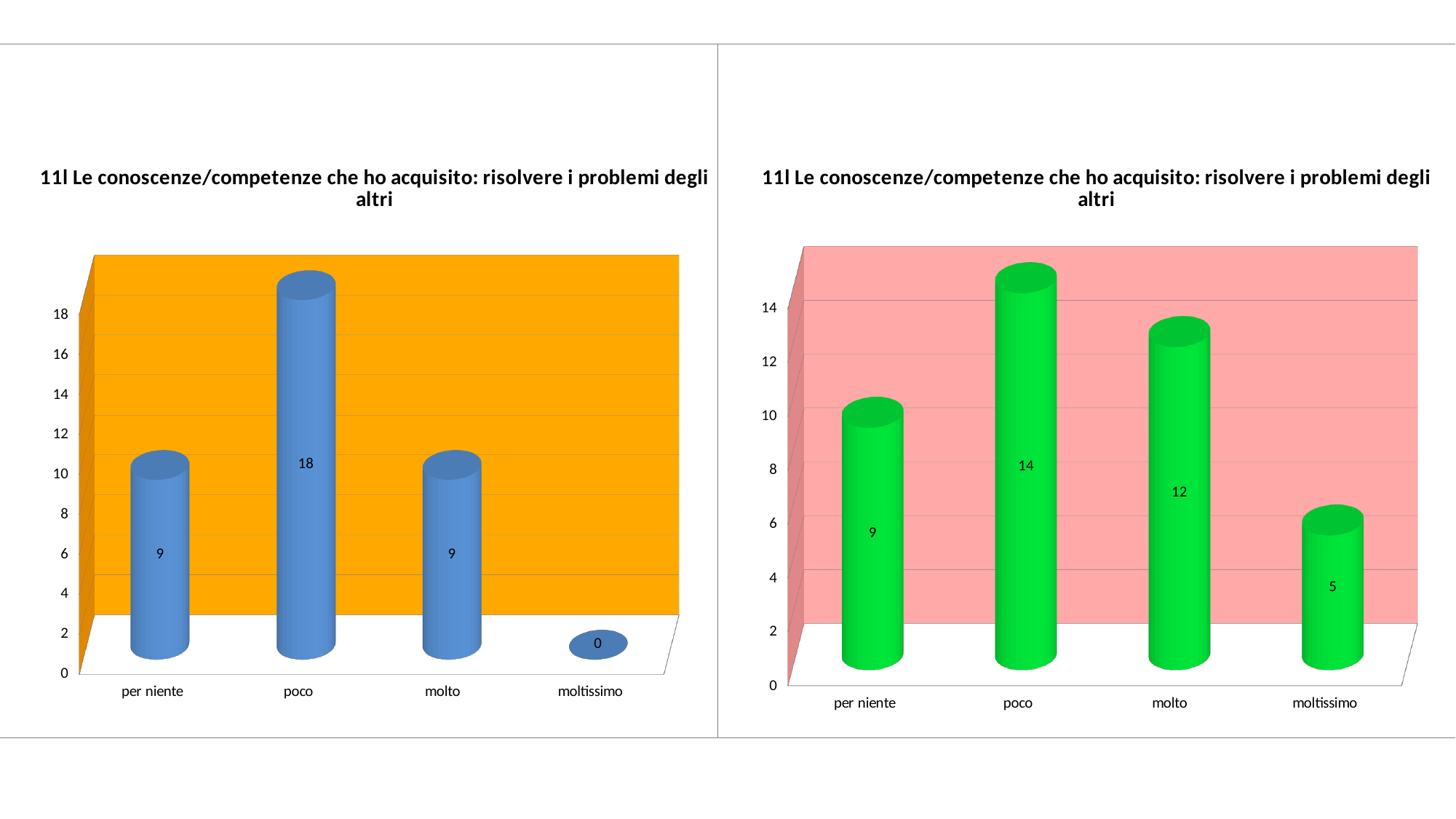
In the left chart, which category has the highest value? poco In the right chart, what is the value for "moltissimo"? 5 In the right chart, what is the difference between the values for "poco" and "molto"? 2 How many categories are shown on the x axis of the left chart? 4 What kind of chart is the right chart? bar chart In the right chart, which category has the lowest value? moltissimo In the left chart, what is the difference between the values for "poco" and "per niente"? 9 In the left chart, what is the value for "poco"? 18 In the right chart, which is larger, the value for "per niente" or the value for "molto"? molto In the right chart, what is the value for "molto"? 12 What colour are the bars in the right chart? green In the left chart, what is the value for "moltissimo"? 0